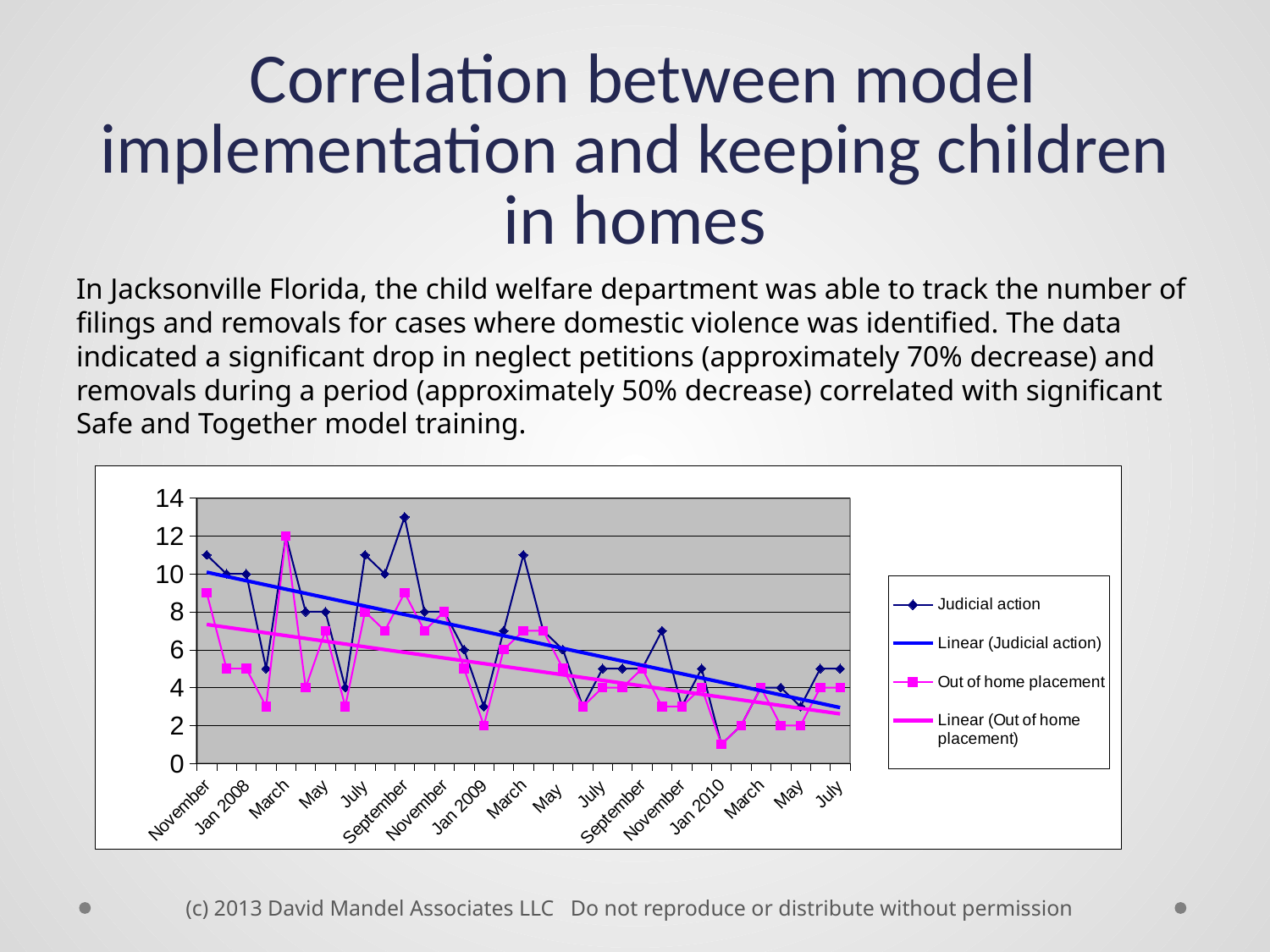
In which month does the Judicial action series reach its highest value? September 2008 How many entries does the chart legend list? 4 Do the Judicial action values generally rise or fall from November 2007 to July 2010? Fall In which month does the Out of home placement series reach its lowest value? Jan 2010 Do the Out of home placement values generally rise or fall over the period shown? Fall Is the Out of home placement value for Jan 2010 greater or less than 2? less In which month does the Out of home placement series reach its highest value? March 2008 Is the Judicial action value for September 2008 greater or less than 12? greater What kind of chart is shown on the slide? Line chart Which series is drawn in pink/magenta with square markers? Out of home placement In September 2008, which is larger: Judicial action or Out of home placement? Judicial action In March 2008, which is larger: Judicial action or Out of home placement? Neither; they are equal (both 12)